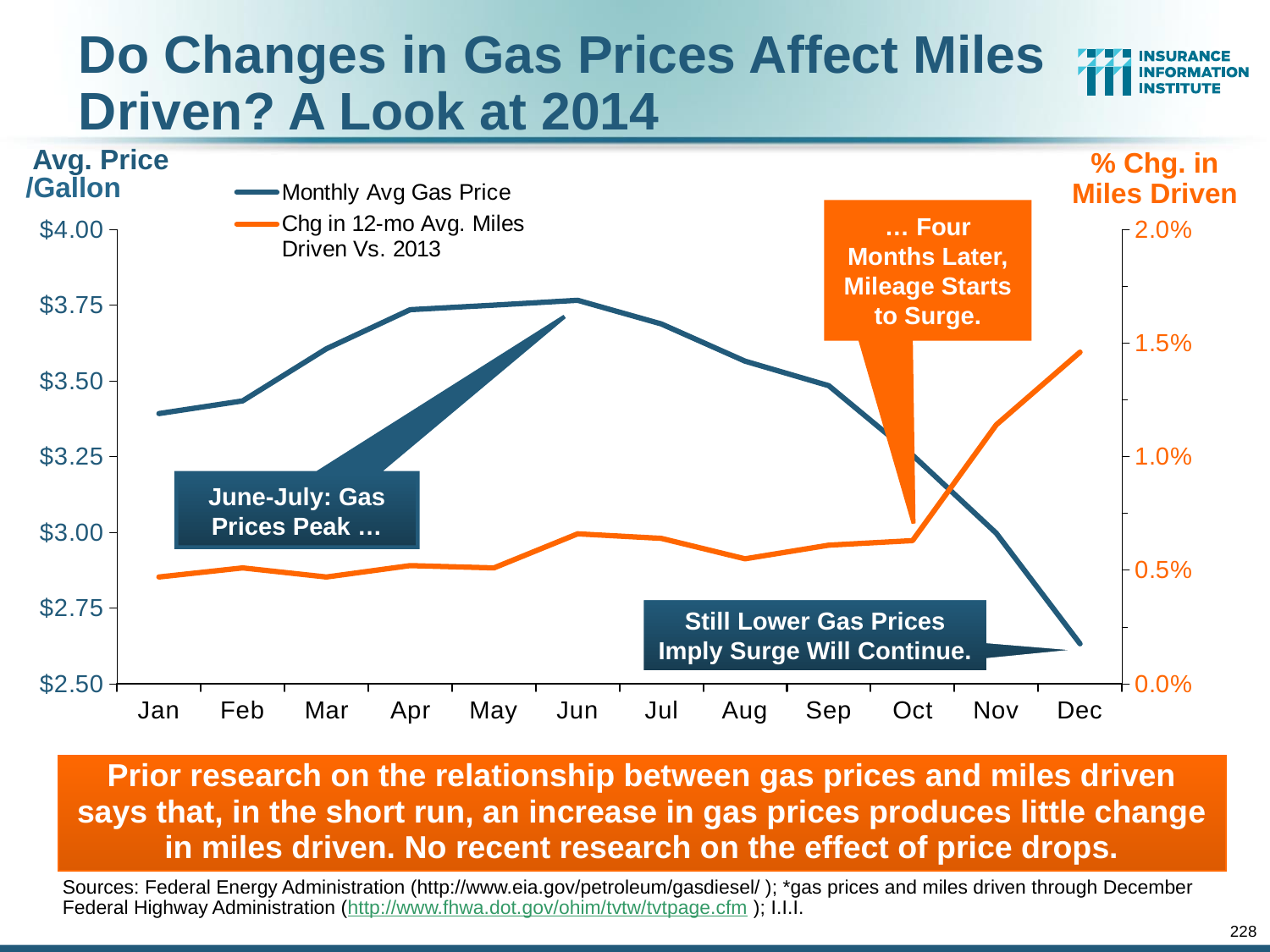
Is the Chg in 12-mo Avg. Miles Driven Vs. 2013 for Dec greater or less than 1.0%? greater How many series does the legend list? 2 In which month is the Monthly Avg Gas Price lowest? Dec In which month is the Chg in 12-mo Avg. Miles Driven Vs. 2013 highest? Dec What kind of chart is shown on the slide? line chart In which month is the Monthly Avg Gas Price highest? Jun Is the Monthly Avg Gas Price for Dec greater or less than $2.75? less Is the Monthly Avg Gas Price for Jun greater or less than $3.50? greater What is the label of the right-hand vertical axis? % Chg. in Miles Driven Which is larger, the Monthly Avg Gas Price in Jun or in Dec? Jun How many months are plotted along the x axis? 12 Does the Monthly Avg Gas Price rise or fall from Jun to Dec? fall